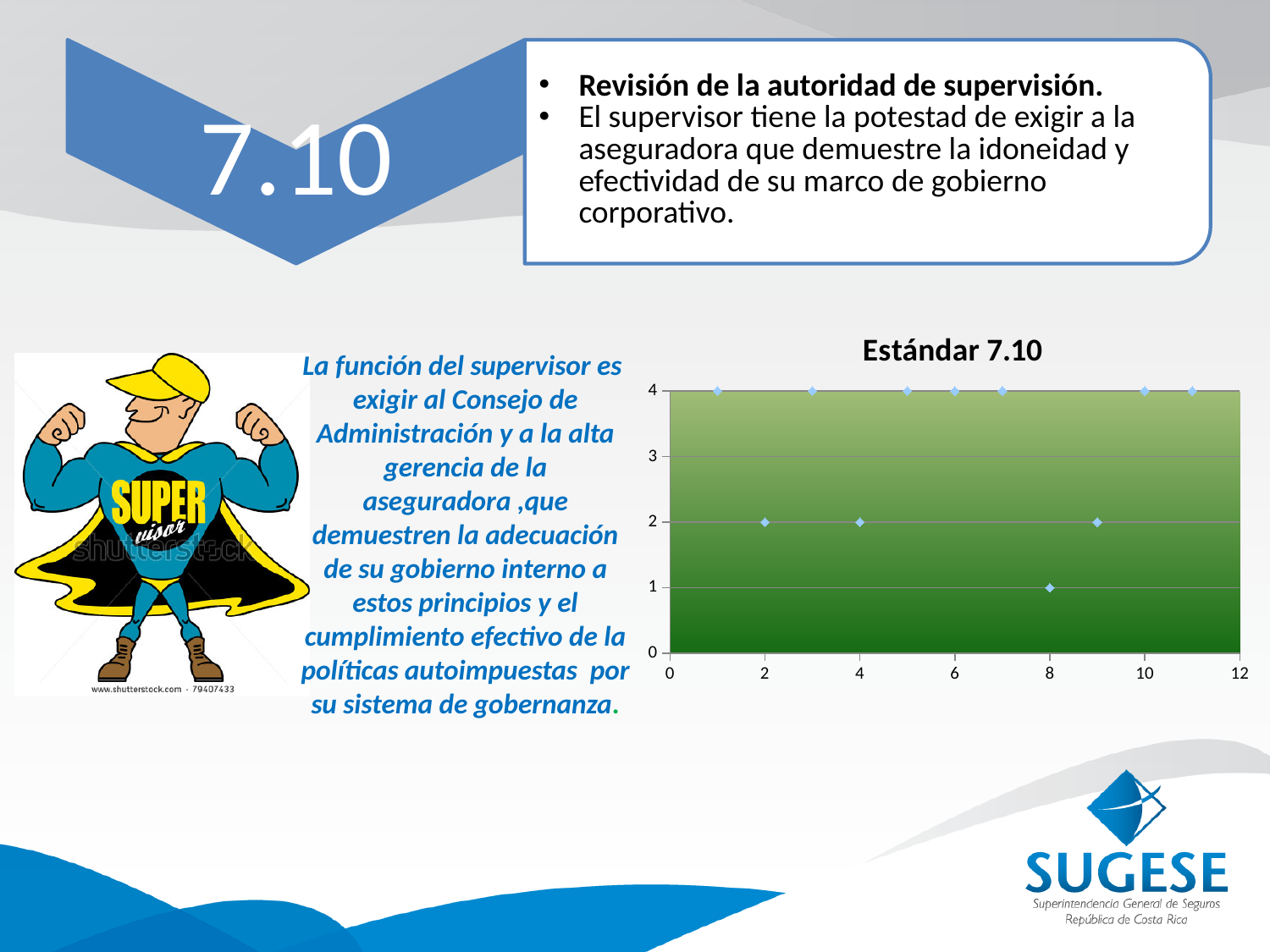
What is the y value of the point at x = 9? 2 What is the y value of the point at x = 8? 1 What is the highest y value reached by any point in the chart? 4 Which point has a larger y value, the one at x = 4 or the one at x = 6? x = 6 At which x value does the lowest point occur? 8 How many data points are plotted in the chart? 11 What is the difference between the y value at x = 1 and the y value at x = 8? 3 What is the title of the chart? Estándar 7.10 How many points have a y value of 4? 7 What kind of chart is shown on the slide? Scatter chart What is the y value of the point at x = 5? 4 What is the y value of the point at x = 2? 2